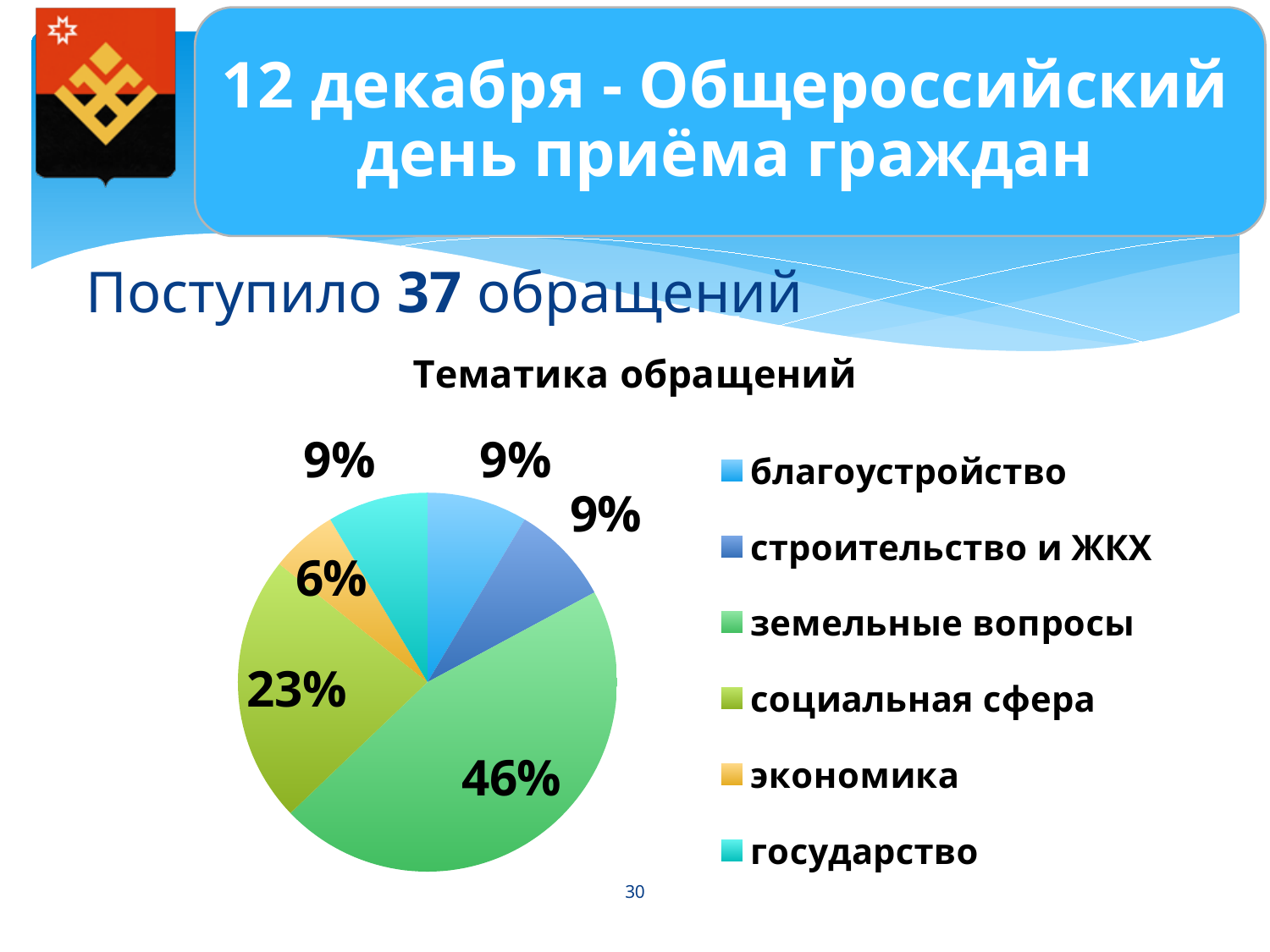
What kind of chart is shown under the title "Тематика обращений"? pie chart What share of the pie does "благоустройство" have? 9% What share of the pie does "экономика" have? 6% Which category has the largest slice of the pie? земельные вопросы Which is larger, the share of "социальная сфера" or the share of "государство"? социальная сфера Which category has the smallest slice of the pie? экономика What is the difference between the shares of "земельные вопросы" and "социальная сфера"? 23% What share of the pie does "земельные вопросы" have? 46% How many categories does the legend of the pie chart list? 6 Which legend entry is shown in green? земельные вопросы What is the title of the pie chart? Тематика обращений